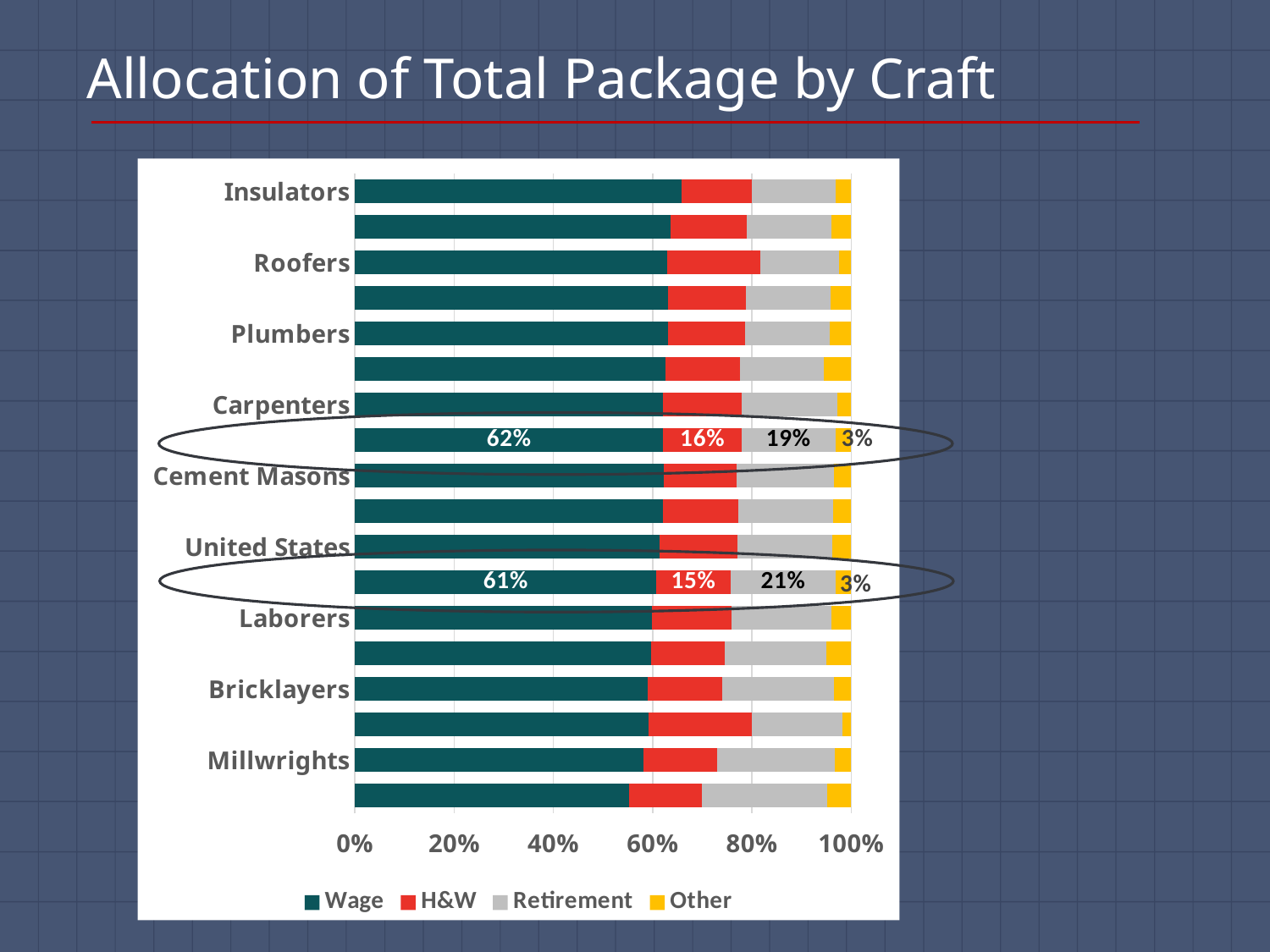
Is the Wage share for Millwrights greater or less than 60%? less Which has the larger Wage share, Insulators or Millwrights? Insulators What kind of chart is shown on the slide? Stacked bar chart In the lower circled bar, what is the Retirement share? 21% How many series does the legend list? 4 In the upper circled bar, how many percentage points larger is the Retirement share than the H&W share? 3 What is the total of the four segments in the lower circled bar? 100% Which series is shown in yellow in the legend? Other In the upper circled bar, what is the Wage share? 62% What is the title of the chart? Allocation of Total Package by Craft In the lower circled bar, what is the H&W share? 15% Is the Wage share for Insulators greater or less than 60%? greater